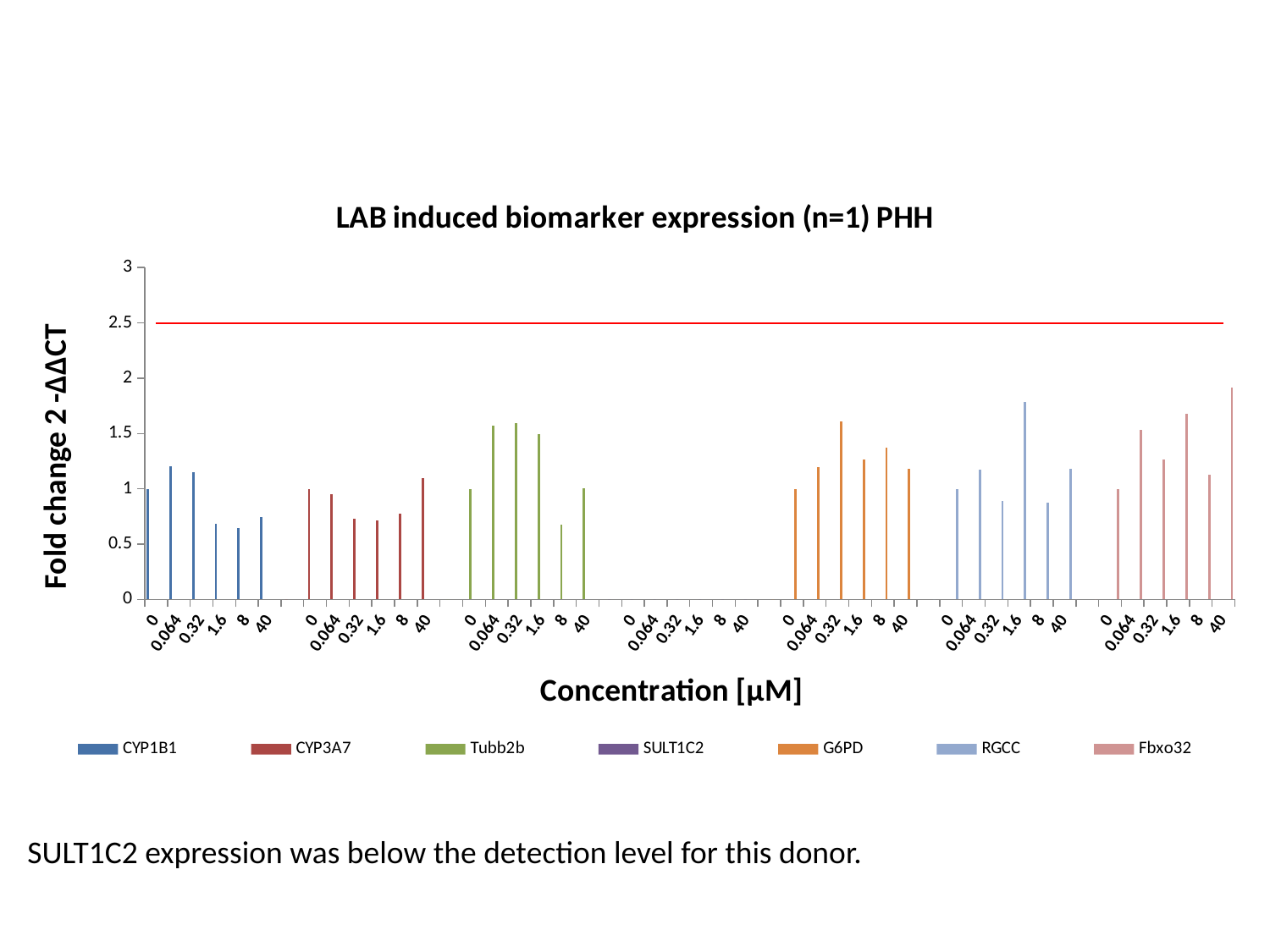
Is the value for Fbxo32 at 40 µM greater or less than 1.5? greater What kind of chart is shown on the slide? bar chart Is the value for CYP1B1 at 1.6 µM greater or less than 1? less Is the value for CYP1B1 at 0.064 µM greater or less than 1? greater At what fold change value is the red horizontal line drawn? 2.5 What is the title of the chart? LAB induced biomarker expression (n=1) PHH How many concentration levels are plotted for each biomarker? 6 Which series has no visible bars in the chart? SULT1C2 For RGCC, which is larger: the value at 1.6 µM or the value at 8 µM? 1.6 µM How many series does the legend list? 7